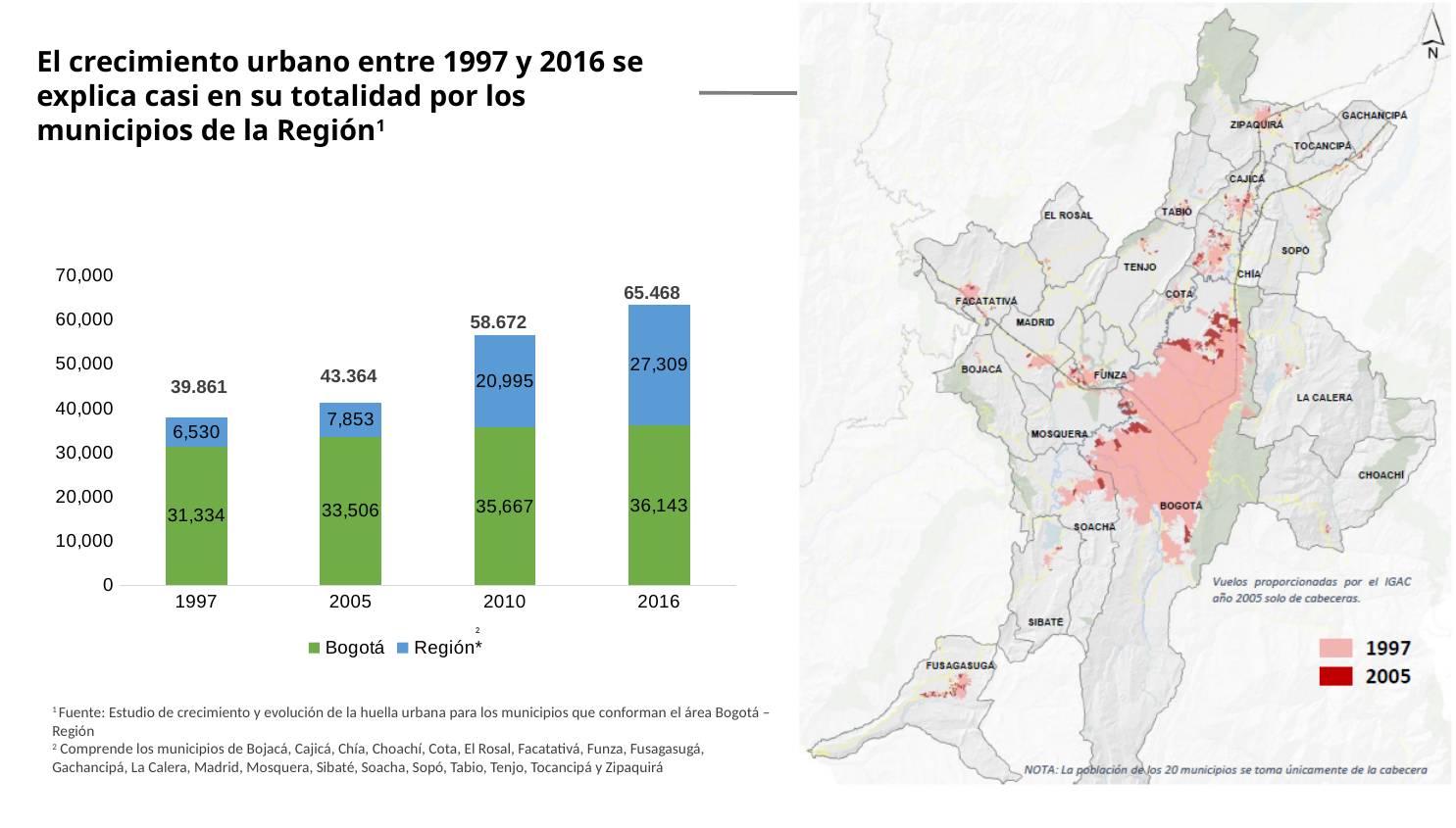
What is the difference between the Región* values for 2010 and 2005? 13,142 What is the value for Región* in 2016? 27,309 In which year is the Bogotá value lowest? 1997 What is the total shown above the stacked bar for 2016? 65.468 How many years are shown on the x axis of the chart? 4 In which year is the Región* value highest? 2016 Which is larger in 2016, the Bogotá value or the Región* value? Bogotá How many series does the chart legend list? 2 What is the value for Región* in 2010? 20,995 What is the value for Bogotá in 1997? 31,334 What is the total shown above the stacked bar for 2005? 43.364 What kind of chart is shown on the slide? Stacked bar chart